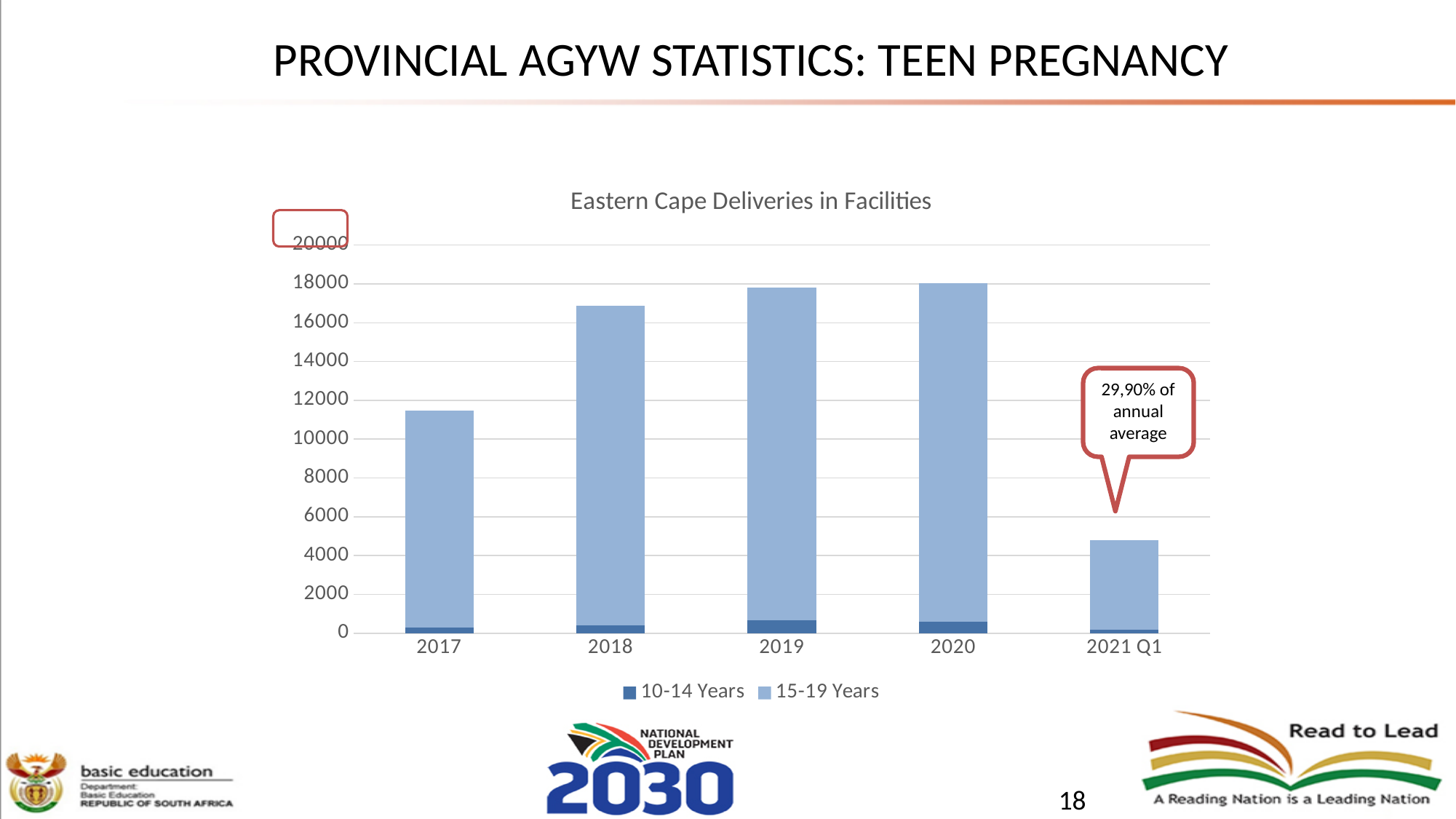
Is the total value for 2018 greater or less than 16000? greater What is the title of the chart? Eastern Cape Deliveries in Facilities Is the total value for 2017 greater or less than 12000? less How many categories are shown on the x axis of the chart? 5 Which has a larger total, 2017 or 2018? 2018 What kind of chart is shown on the slide? Stacked bar chart What does the callout next to the 2021 Q1 bar say? 29,90% of annual average How many series does the legend list? 2 Is the total value for 2020 greater or less than 16000? greater Which category has the lowest total deliveries? 2021 Q1 Do the total deliveries rise or fall from 2017 to 2020? rise